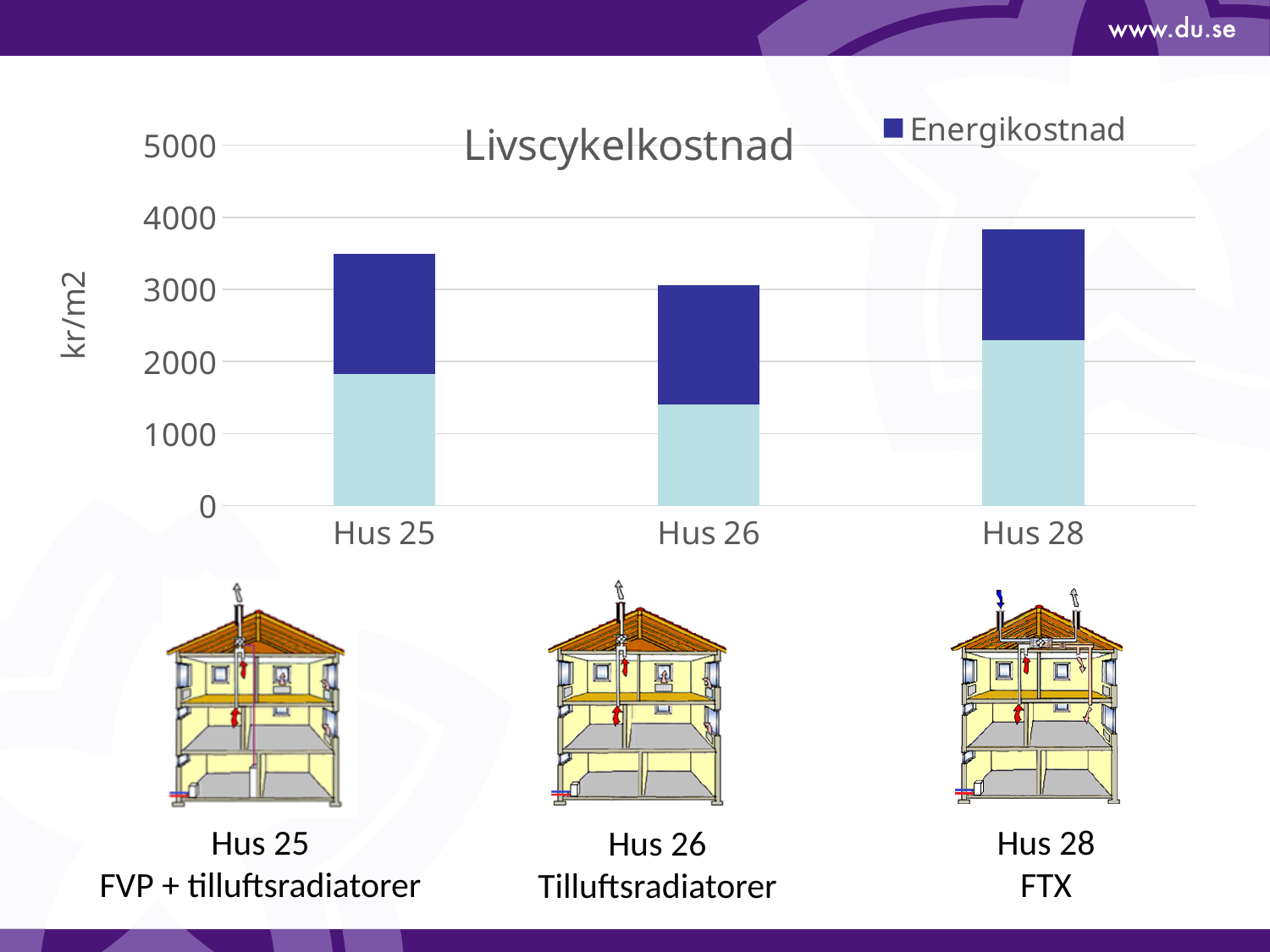
What is the title of the chart? Livscykelkostnad Is the light blue segment for Hus 28 greater or less than 2000? greater Which has the larger total bar, Hus 25 or Hus 28? Hus 28 Which house has the lowest total bar in the chart? Hus 26 Which house has the highest total bar in the chart? Hus 28 Is the total bar for Hus 28 greater or less than 4000? less How many categories (houses) are shown on the x axis of the chart? 3 Is the light blue segment for Hus 26 greater or less than 2000? less Which has the larger total bar, Hus 25 or Hus 26? Hus 25 What kind of chart is shown on the slide? Stacked bar chart What is the label on the vertical axis of the chart? kr/m2